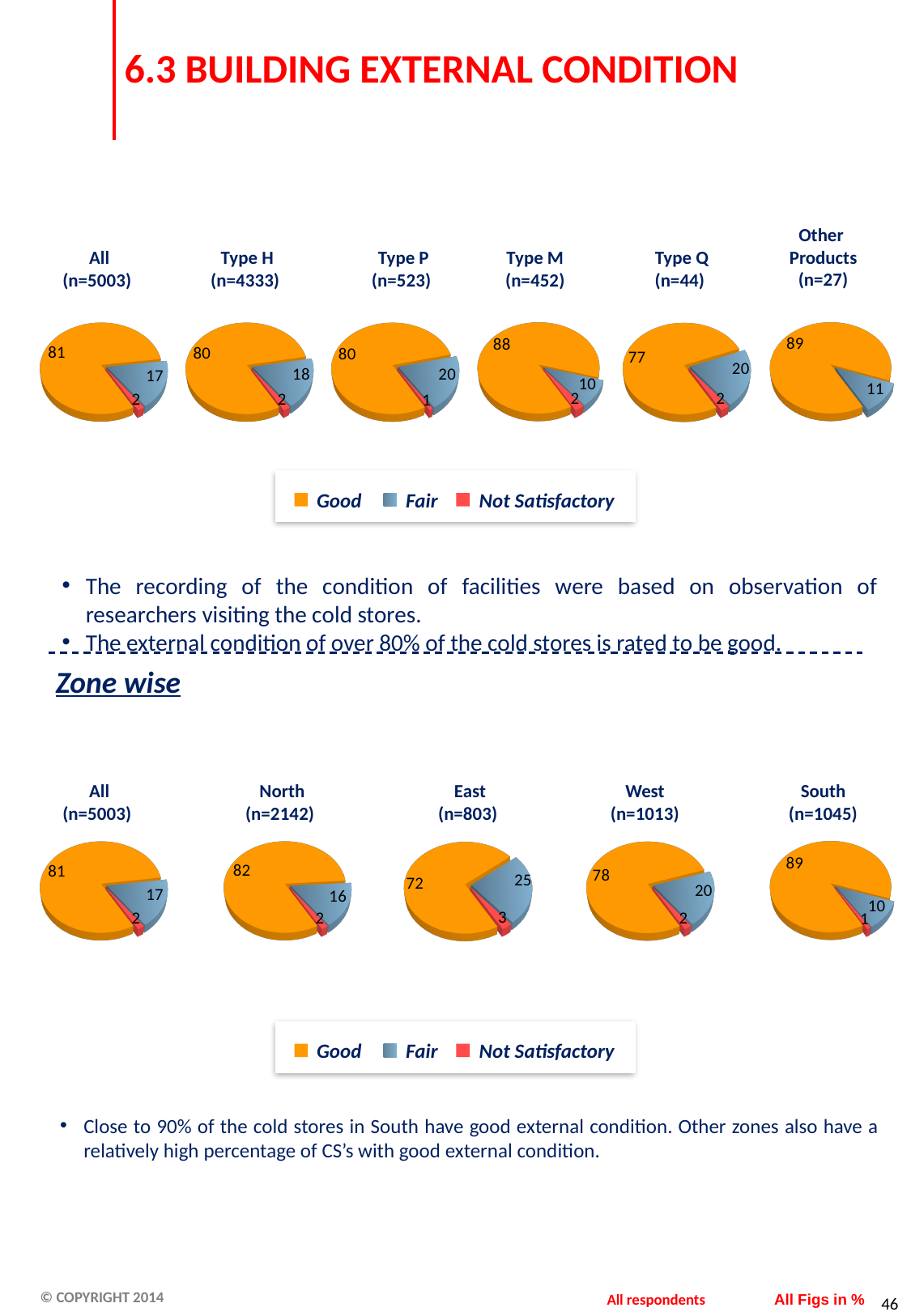
In the Zone wise pie charts, which zone has the highest Good value? South (n=1045) In the top row of pie charts, what is the Fair value for Type P (n=523)? 20 In the top row of pie charts, what is the difference between the Good values for Type M and Type Q? 11 In the Zone wise pie charts, what is the difference between the Good values for South and East? 17 In the top row of pie charts, what is the Not Satisfactory value for Type H (n=4333)? 2 In the top row of pie charts, what is the Good value for Type M (n=452)? 88 In the Zone wise pie charts, what is the Fair value for East (n=803)? 25 How many pie charts are in the Zone wise row? 5 How many entries does the legend below the top row of pie charts list? 3 In the top row of pie charts, which type has the lowest Good value? Type Q (n=44) In the Zone wise pie charts, which zone has the lowest Good value? East (n=803) In the Zone wise pie charts, is the Good value larger for North or West? North